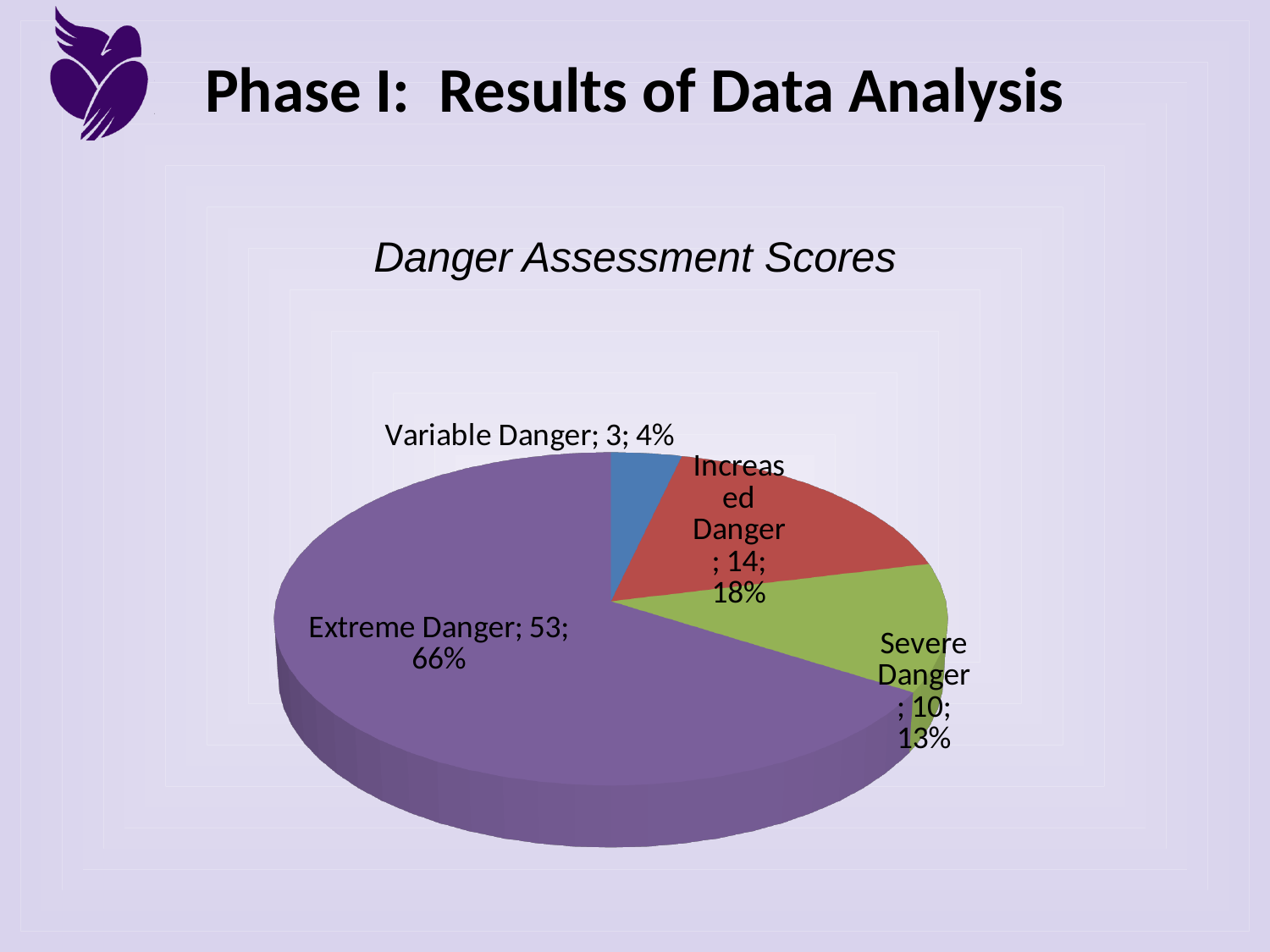
What percentage share does Increased Danger have? 18% What is the title of the chart? Danger Assessment Scores Which is larger, the count for Severe Danger or the count for Increased Danger? Increased Danger Which category has the smallest slice? Variable Danger Which category has the largest slice? Extreme Danger What is the count for Extreme Danger? 53 How many slices does the pie chart have? 4 What kind of chart is shown on the slide? Pie chart What percentage share does Variable Danger have? 4% What is the difference between the counts for Extreme Danger and Increased Danger? 39 What is the count for Severe Danger? 10 What colour is the Extreme Danger slice? Purple